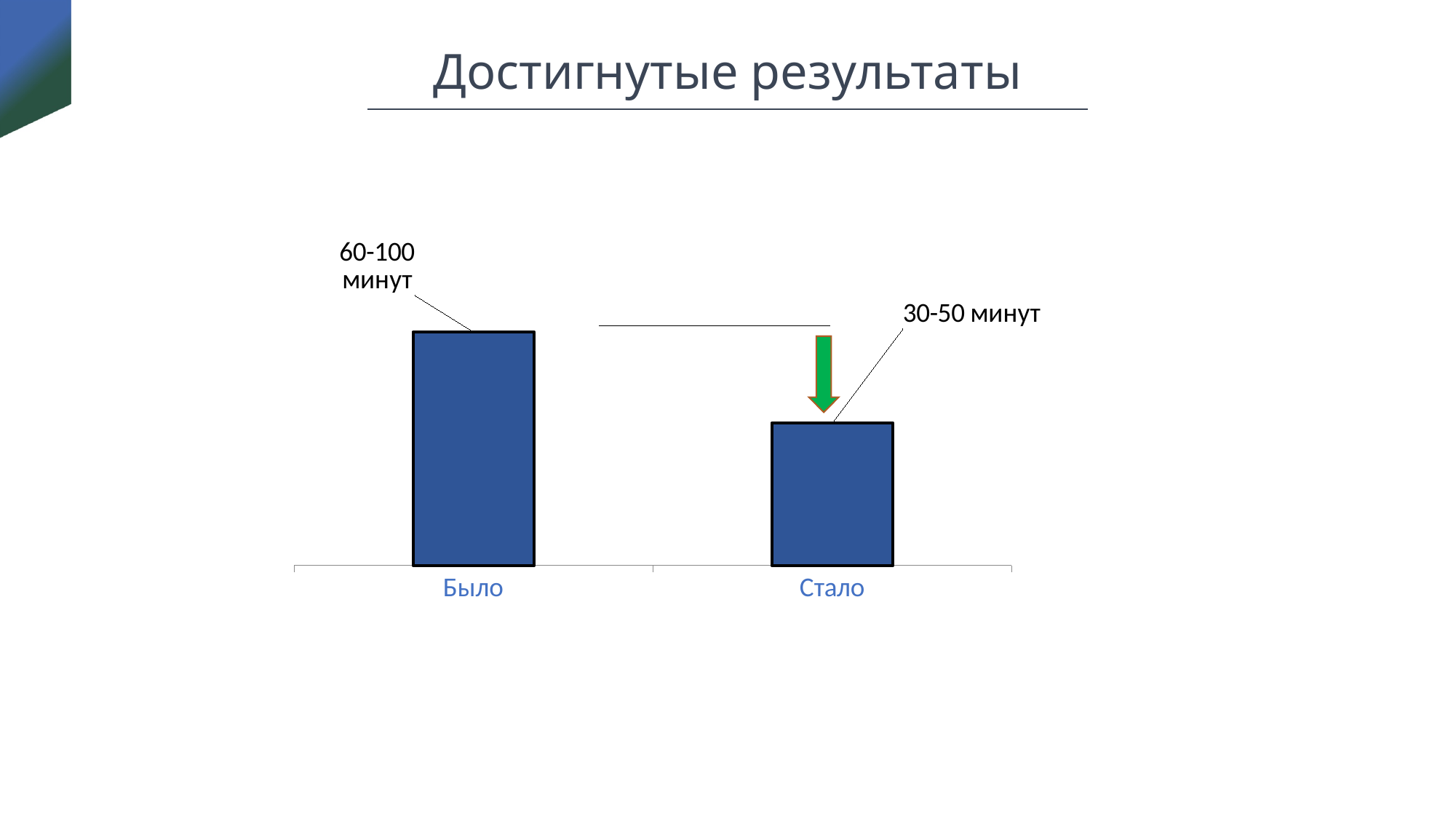
What value is labelled on the bar for Стало? 30-50 минут What is the title of the slide? Достигнутые результаты Which bar is taller, Было or Стало? Было What value is labelled on the bar for Было? 60-100 минут What colour is the arrow pointing down at the Стало bar? Green What kind of chart is shown on the slide? Bar chart Which category has the tallest bar? Было Which category has the shortest bar? Стало How many bars are shown in the chart? 2 Do the values rise or fall from Было to Стало? Fall